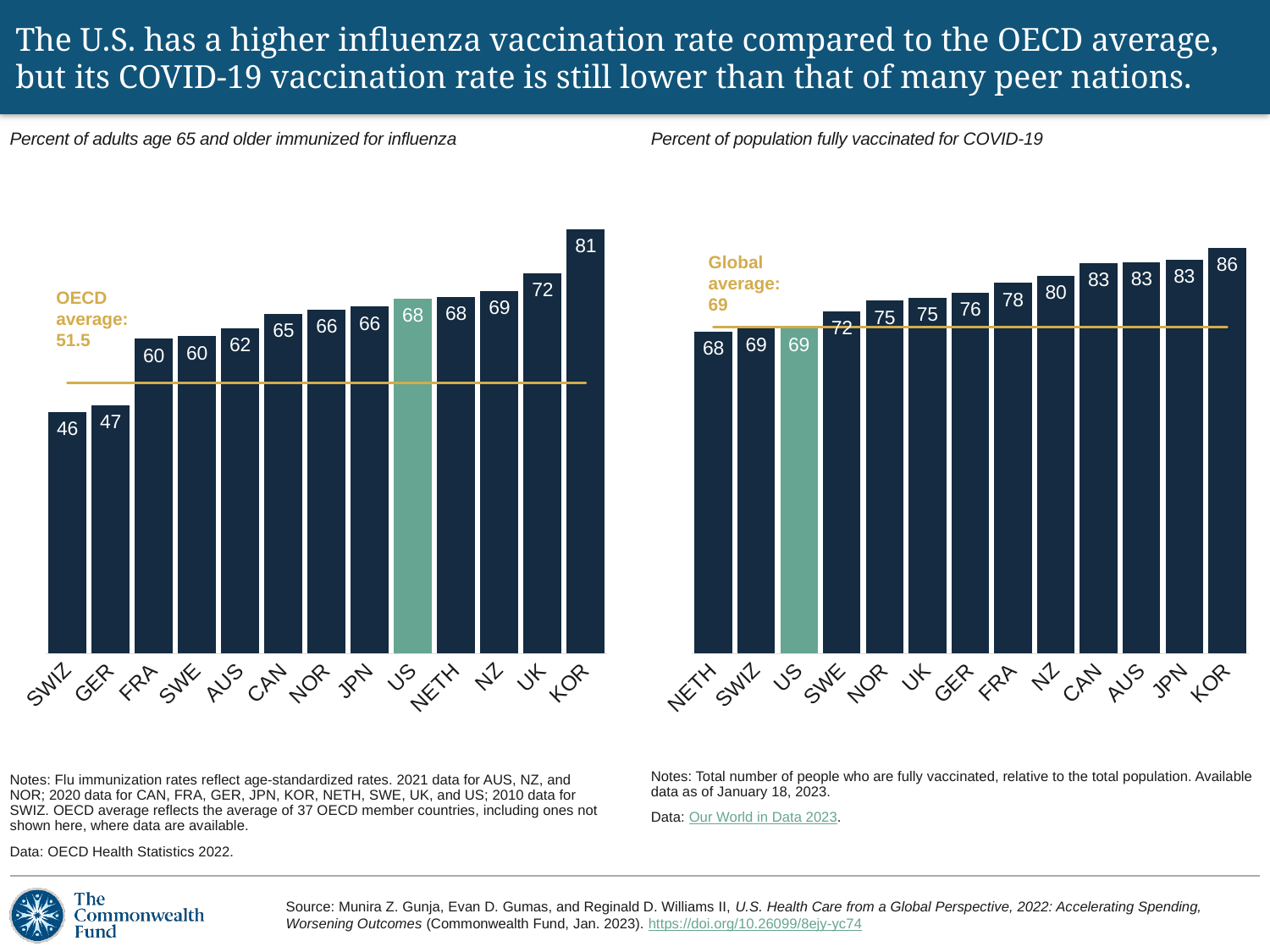
How many countries are shown in the COVID-19 chart? 13 In the COVID-19 chart, what is the difference between KOR and the US? 17 In the influenza chart, which is larger, the value for UK or the value for NZ? UK What type of chart is the influenza chart? Bar chart In the influenza chart, what is the value for the US? 68 In the COVID-19 chart, what is the value for the US? 69 What is the OECD average shown in the influenza chart? 51.5 In the influenza chart, which country has the lowest value? SWIZ In the COVID-19 chart, which country has the highest value? KOR In the influenza chart, what is the difference between KOR and SWIZ? 35 In the COVID-19 chart, which country has the lowest value? NETH In the influenza chart, which country has the highest value? KOR